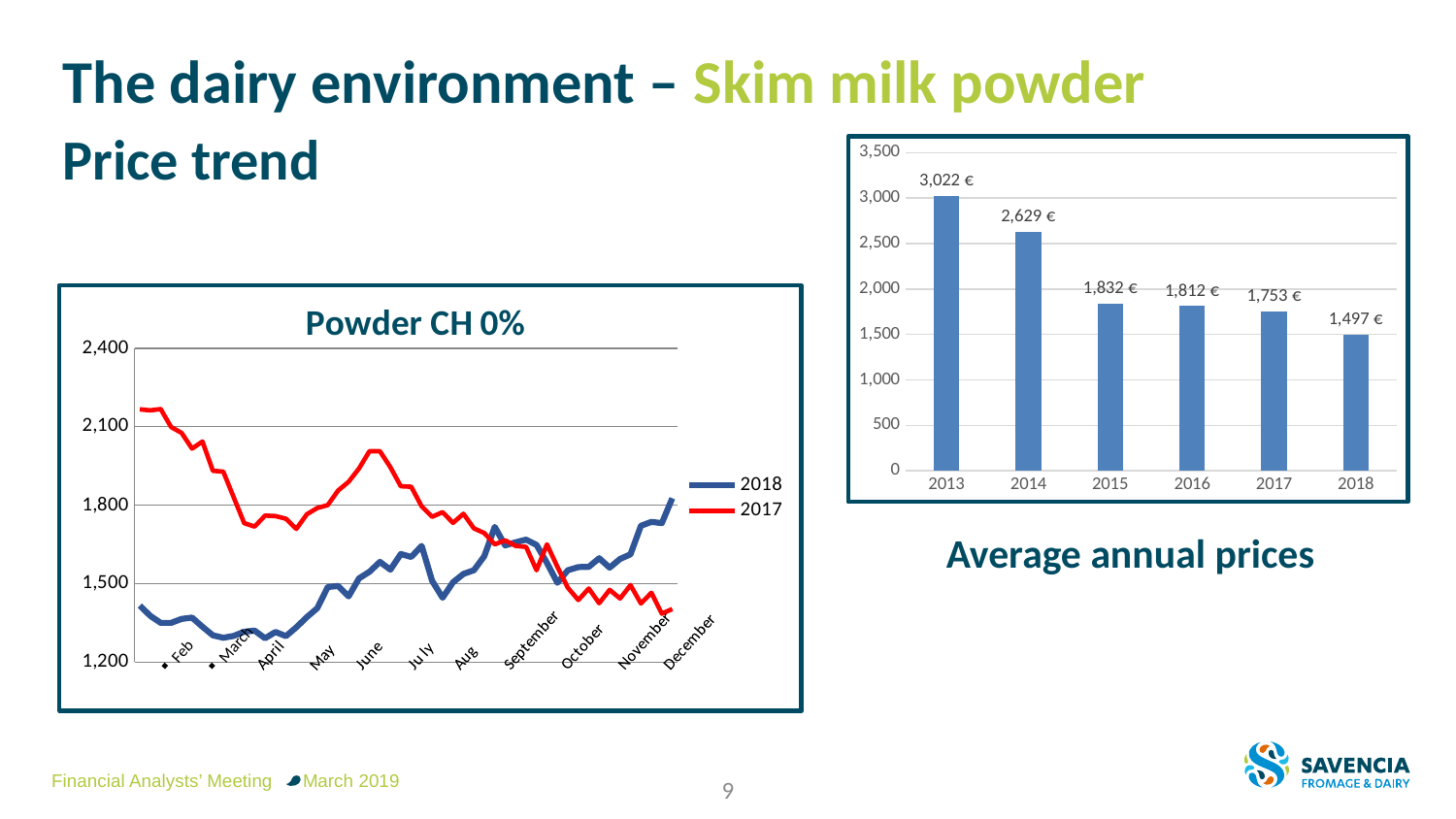
In the Average annual prices chart, which year has the lowest value? 2018 What kind of chart is the Average annual prices chart? bar chart In the Average annual prices chart, what is the value for 2016? 1,812 € In the Average annual prices chart, which year has the highest value? 2013 In the Average annual prices chart, do the values rise or fall from 2013 to 2018? fall In the Average annual prices chart, what is the value for 2013? 3,022 € How many series does the legend of the Powder CH 0% chart list? 2 In the Average annual prices chart, what is the difference between the 2013 and 2014 values? 393 € In the Average annual prices chart, what is the value for 2018? 1,497 € In the Average annual prices chart, how many years are shown? 6 In the Average annual prices chart, what is the difference between the 2017 and 2018 values? 256 € In the Powder CH 0% chart, is the 2017 value in June greater or less than 1,800? greater